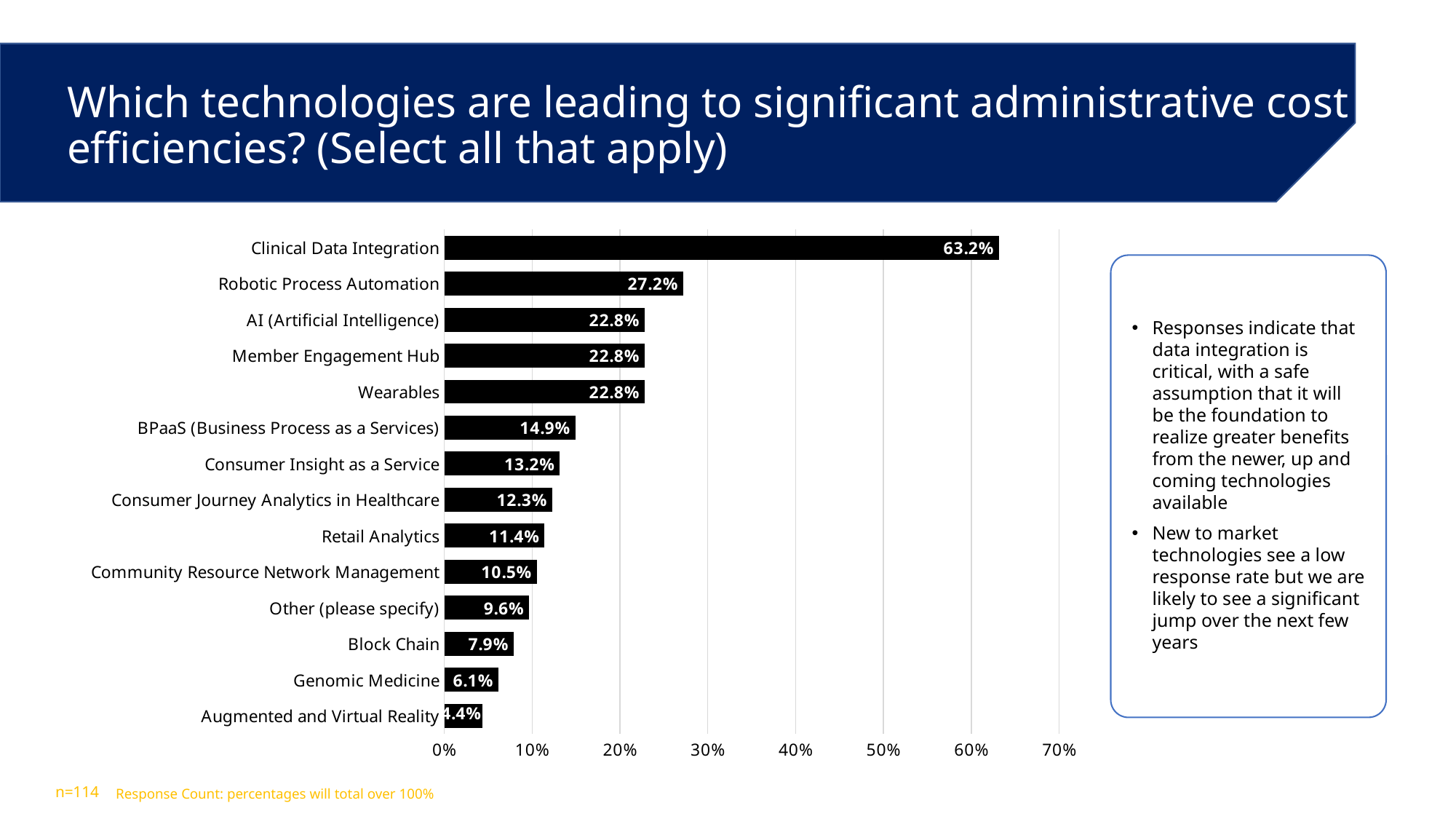
What percentage of respondents selected Clinical Data Integration? 63.2% Which technology has the lowest percentage? Augmented and Virtual Reality Which has a larger value, Retail Analytics or Consumer Insight as a Service? Consumer Insight as a Service Is the value for Clinical Data Integration greater or less than 60%? greater What is the sample size (n) noted at the bottom of the slide? n=114 What is the value shown for Robotic Process Automation? 27.2% Which technology has the highest percentage? Clinical Data Integration What kind of chart is shown on the slide? Bar chart How many technology categories are shown in the chart? 14 What is the difference between the values for BPaaS (Business Process as a Services) and Genomic Medicine? 8.8% What percentage is shown for Block Chain? 7.9% What is the difference between the values for Clinical Data Integration and Robotic Process Automation? 36.0%